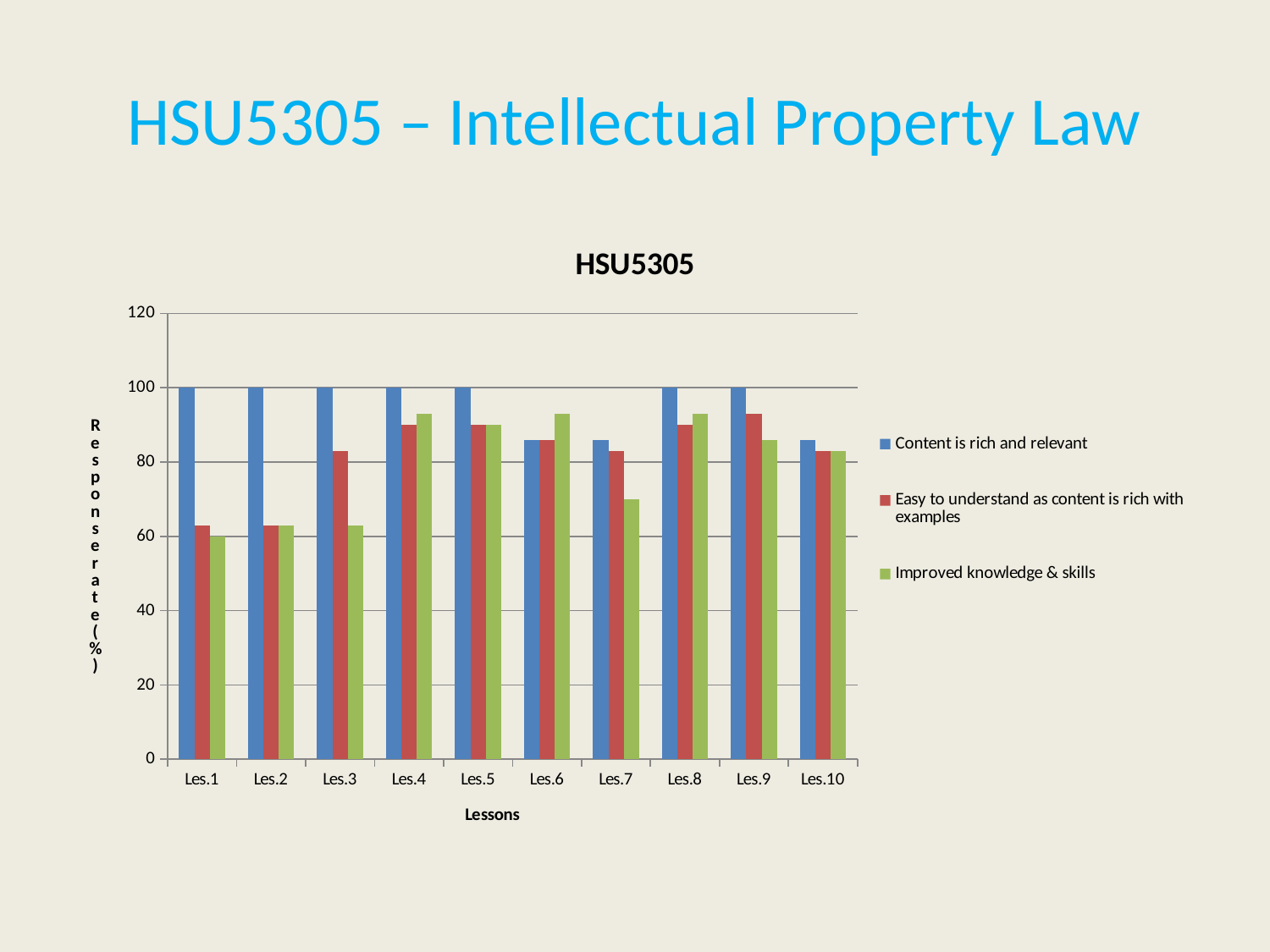
What is the x-axis title of the chart? Lessons What is the title of the chart? HSU5305 What is the value for 'Content is rich and relevant' for Les.1? 100 Is the value for 'Improved knowledge & skills' for Les.7 greater or less than 80? less What kind of chart is shown on the slide? bar chart How many lessons are shown on the x axis of the chart? 10 Is the value for 'Content is rich and relevant' for Les.7 greater or less than 80? greater For Les.3, which is larger: 'Easy to understand as content is rich with examples' or 'Improved knowledge & skills'? Easy to understand as content is rich with examples What is the value for 'Content is rich and relevant' for Les.9? 100 Is the value for 'Improved knowledge & skills' for Les.1 greater or less than 80? less How many series does the legend list? 3 For Les.1, which is larger: 'Content is rich and relevant' or 'Improved knowledge & skills'? Content is rich and relevant